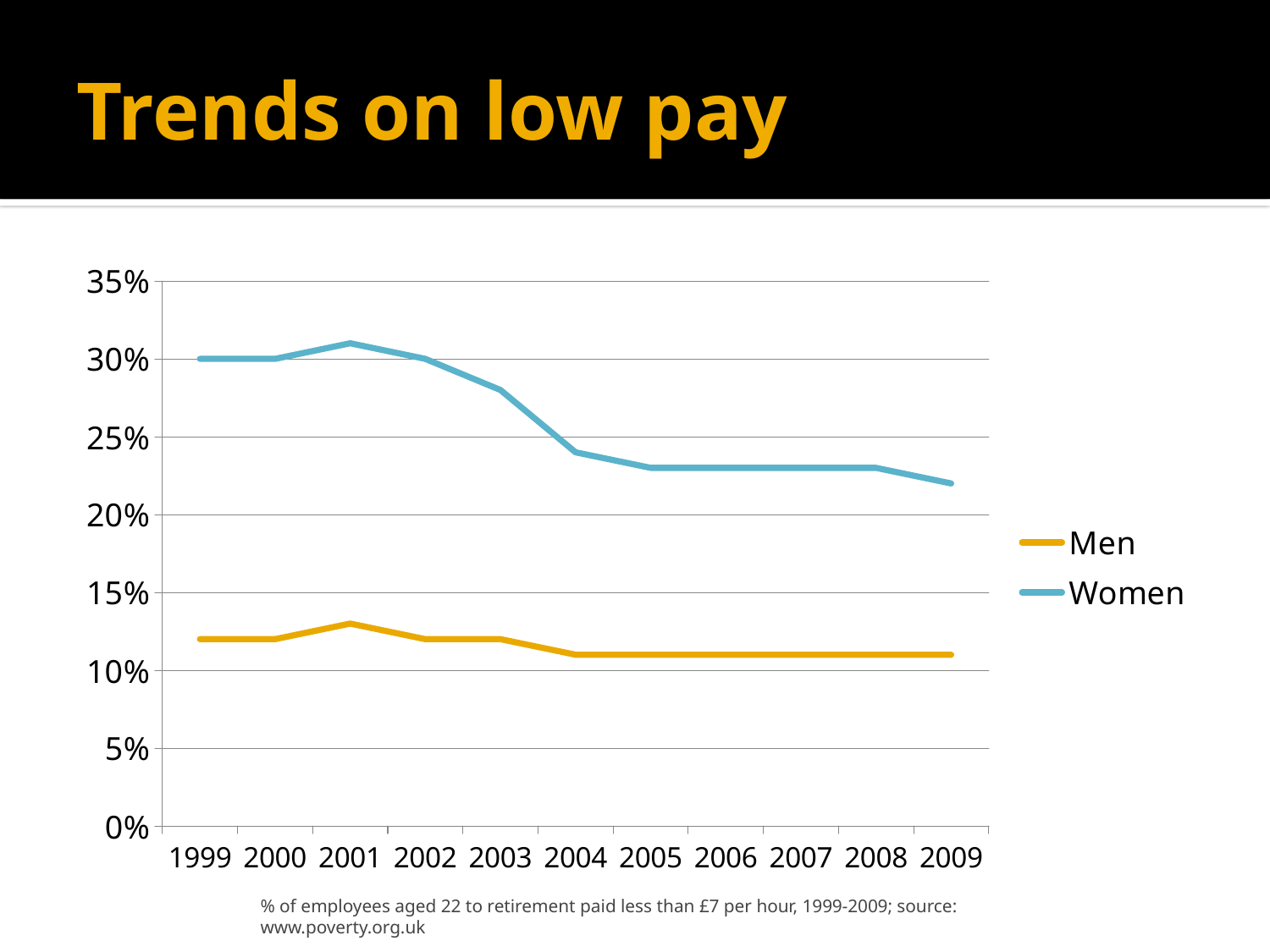
In which year is the Women series at its lowest? 2009 Is the value for Women in 2009 greater or less than 25%? less What is the value for Women in 1999? 30% In which year is the Women series at its highest? 2001 In which year is the Men series at its highest? 2001 Does the Women series rise or fall overall from 1999 to 2009? fall How many series does the legend list? 2 What is the value for Women in 2000? 30% Which series has the larger value in 2005, Men or Women? Women Is the value for Men in 2009 greater or less than 10%? greater What kind of chart is shown on the slide? line chart How many years are shown on the x axis? 11